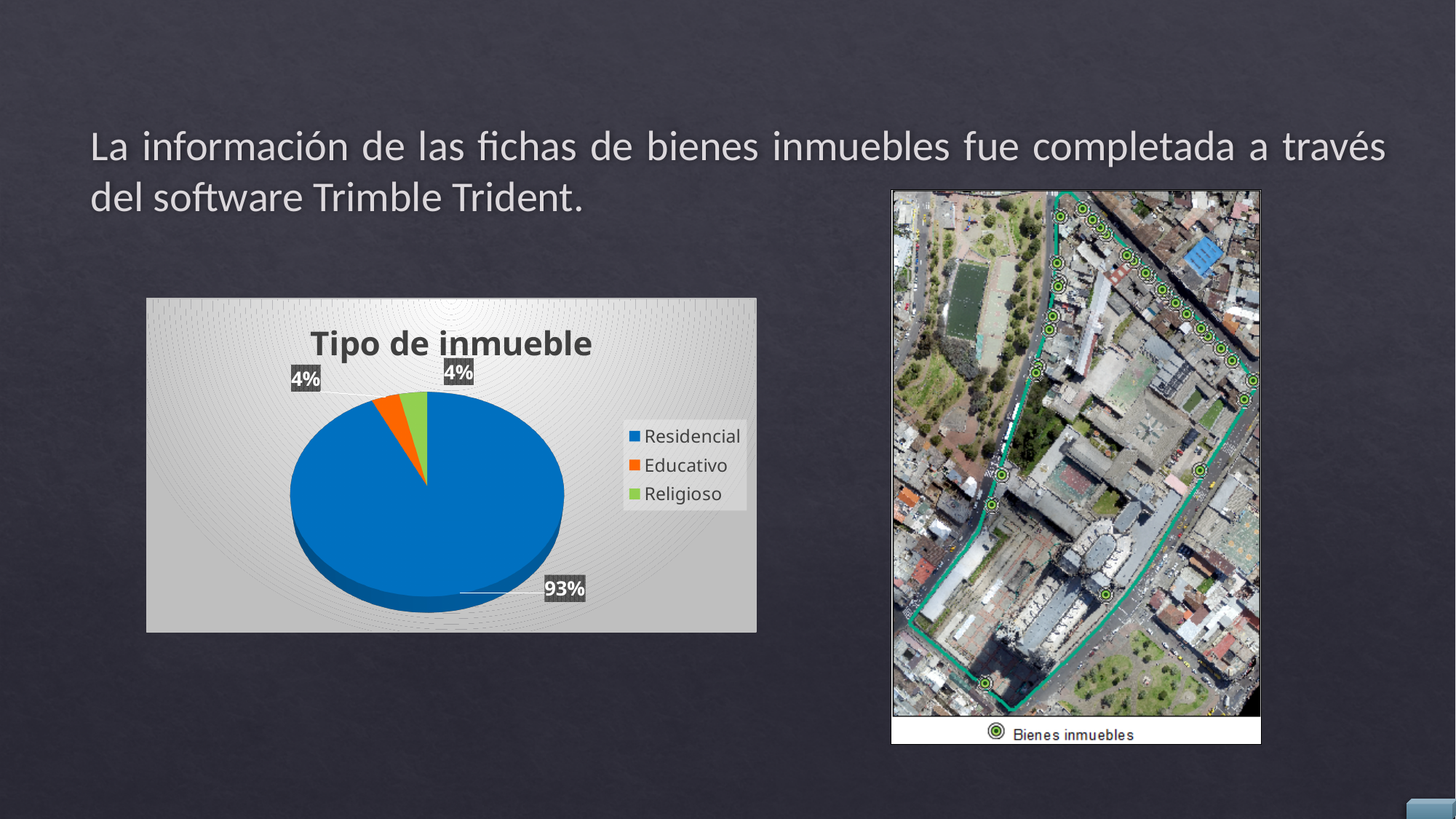
In the 'Tipo de inmueble' chart, which is larger: Residencial or Educativo? Residencial What kind of chart is 'Tipo de inmueble'? Pie chart What percentage is shown for Educativo in the 'Tipo de inmueble' chart? 4% In the 'Tipo de inmueble' chart, what is the difference in percentage points between Residencial and Religioso? 89 percentage points What percentage is shown for Religioso in the 'Tipo de inmueble' chart? 4% What share of the pie does Residencial have in the 'Tipo de inmueble' chart? 93% What is the title of the pie chart on the slide? Tipo de inmueble What colour represents Educativo in the 'Tipo de inmueble' chart? Orange Which category has the largest slice in the 'Tipo de inmueble' chart? Residencial How many categories are shown in the 'Tipo de inmueble' pie chart? 3 How many entries does the legend of the 'Tipo de inmueble' chart list? 3